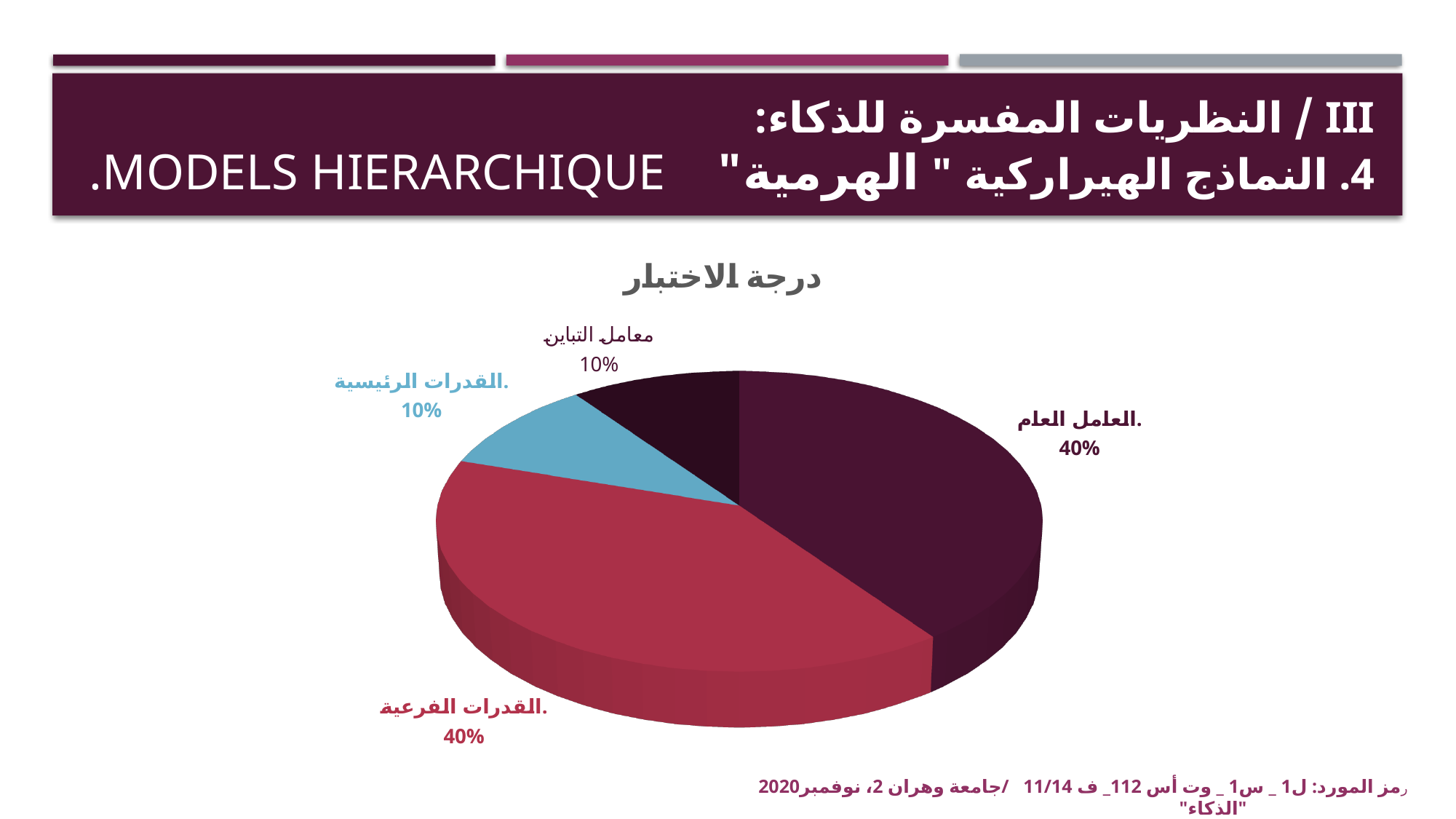
What share of the pie does معامل التباين represent? 10% Which slice of the pie is coloured light blue? القدرات الرئيسية What share of the pie does القدرات الفرعية represent? 40% What share of the pie does القدرات الرئيسية represent? 10% What is the difference between the share for العامل العام and the share for القدرات الرئيسية? 30% How many slices does the pie chart have? 4 What is the title of the chart? درجة الاختبار What is the combined share of العامل العام and القدرات الفرعية? 80% Which is larger, the share for القدرات الرئيسية or the share for القدرات الفرعية? القدرات الفرعية What type of chart is shown on the slide? Pie chart Which is larger, the share for العامل العام or the share for معامل التباين? العامل العام